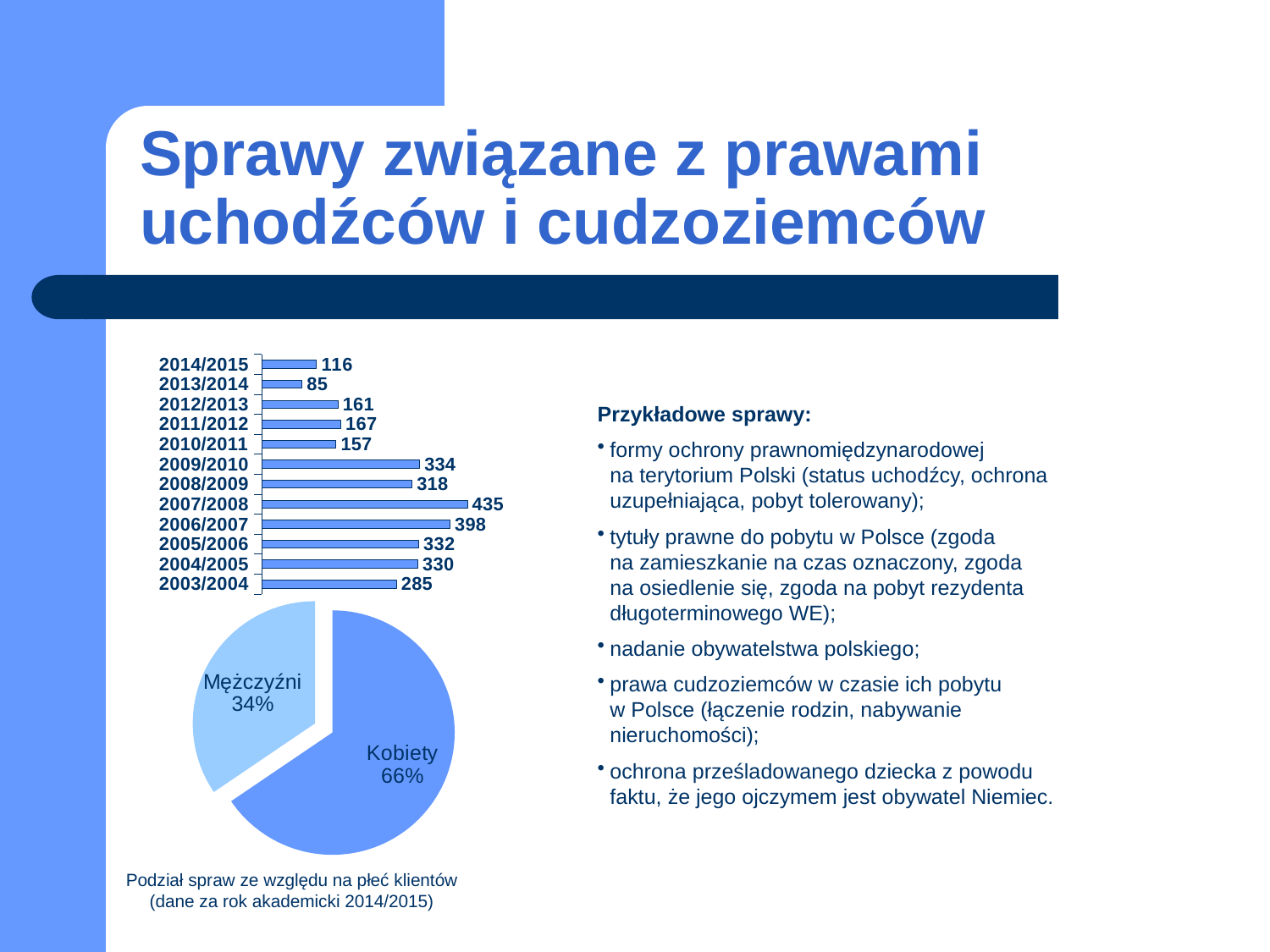
In the bar chart, which academic year has the lowest value? 2013/2014 What type of chart is the upper chart on the slide? bar chart In the bar chart, what is the difference between the values for 2007/2008 and 2013/2014? 350 In the pie chart, how many slices are there? 2 In the bar chart, which is larger: the value for 2009/2010 or the value for 2008/2009? 2009/2010 In the bar chart, how many academic years are shown? 12 In the bar chart, what is the value for 2013/2014? 85 In the bar chart, what is the difference between the values for 2014/2015 and 2013/2014? 31 In the bar chart, which academic year has the highest value? 2007/2008 In the pie chart, what share of cases is for Kobiety? 66% In the pie chart, what share of cases is for Mężczyźni? 34% In the bar chart, what is the value for 2007/2008? 435